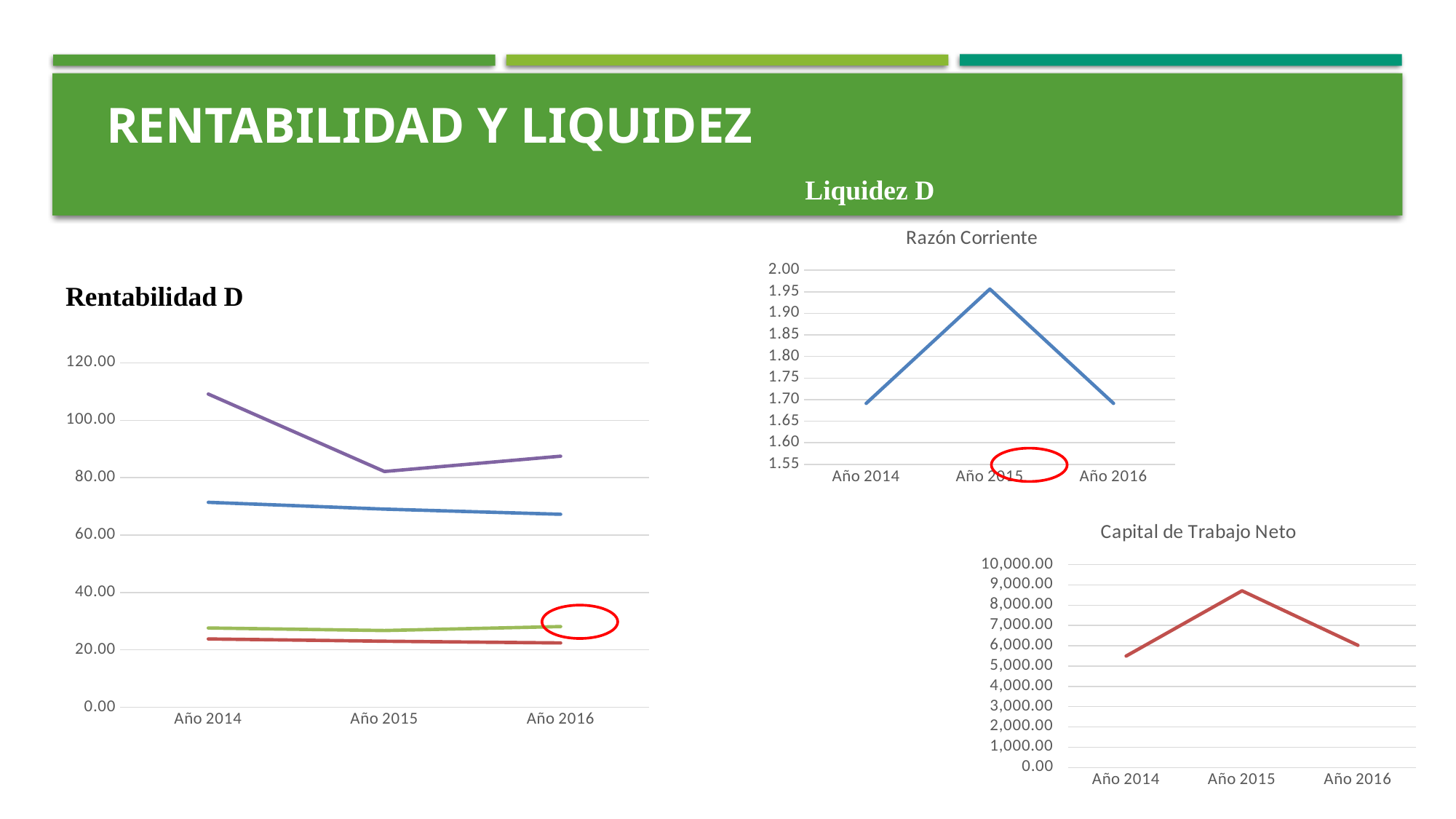
In the Rentabilidad D chart, which is larger at Año 2015: the purple line or the blue line? the purple line How many years are plotted on the x axis of the Capital de Trabajo Neto chart? 3 In the Razón Corriente chart, is the value for Año 2015 greater or less than 1.90? greater In the Rentabilidad D chart, is the purple line's value for Año 2014 greater or less than 100.00? greater In the Capital de Trabajo Neto chart, is the value for Año 2016 greater or less than 7,000.00? less What kind of chart is the Razón Corriente chart? line chart In the Capital de Trabajo Neto chart, which year has the lowest value? Año 2014 In the Razón Corriente chart, which year has the highest value? Año 2015 In the Rentabilidad D chart, does the blue line rise or fall from Año 2014 to Año 2016? fall In the Capital de Trabajo Neto chart, which year has the highest value? Año 2015